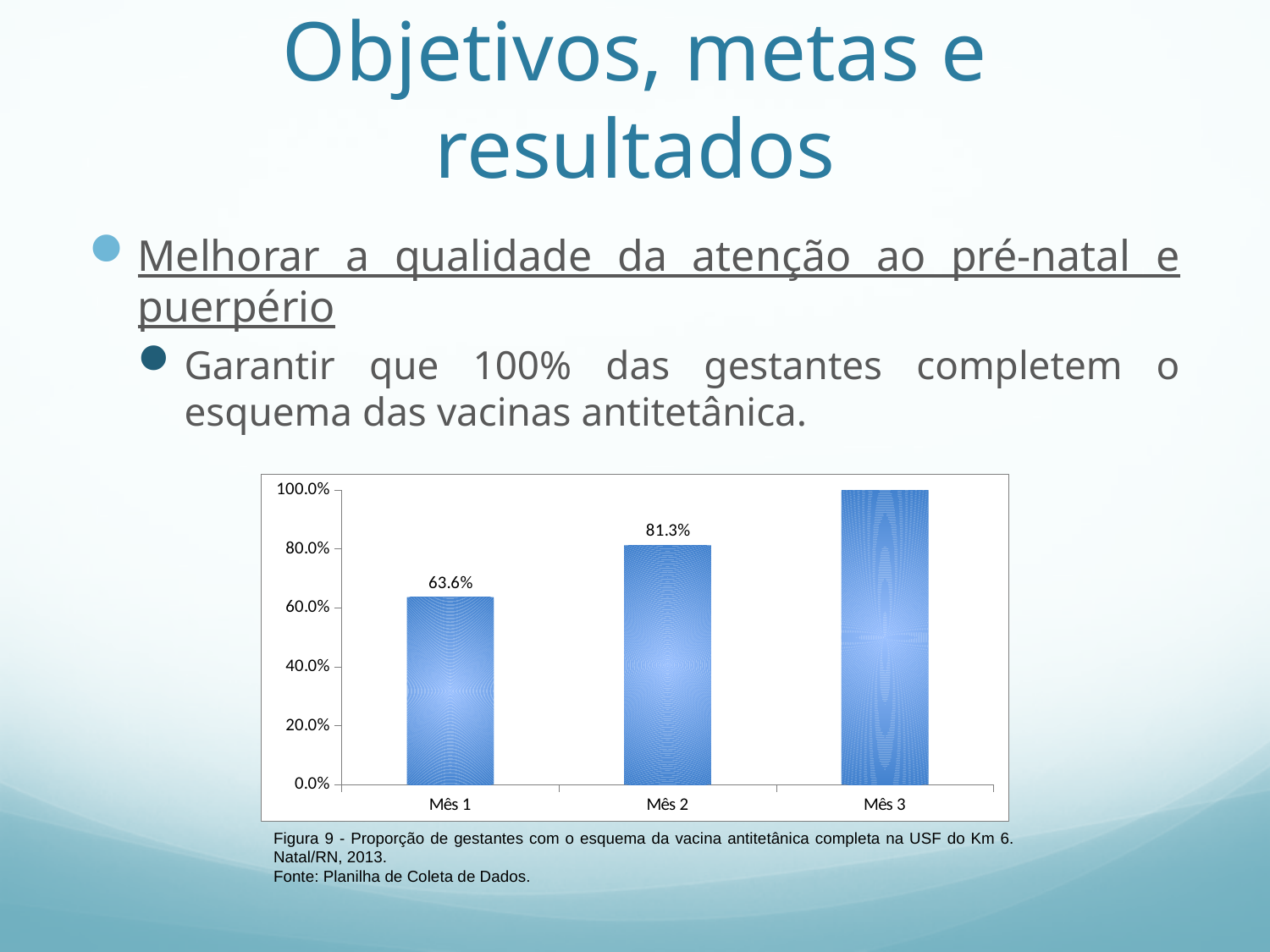
Which month has the lowest value? Mês 1 Is the value for Mês 3 greater or less than 80.0%? greater Do the values rise or fall from Mês 1 to Mês 3? rise Is the value for Mês 1 greater or less than 60.0%? greater How many months are shown on the x axis? 3 What kind of chart is shown on the slide? bar chart What is the value for Mês 1? 63.6% Which is larger, the value for Mês 1 or the value for Mês 2? Mês 2 Which month has the highest value? Mês 3 What is the figure number given in the caption below the chart? Figura 9 What is the difference between the values for Mês 2 and Mês 1? 17.7 percentage points What is the value for Mês 2? 81.3%